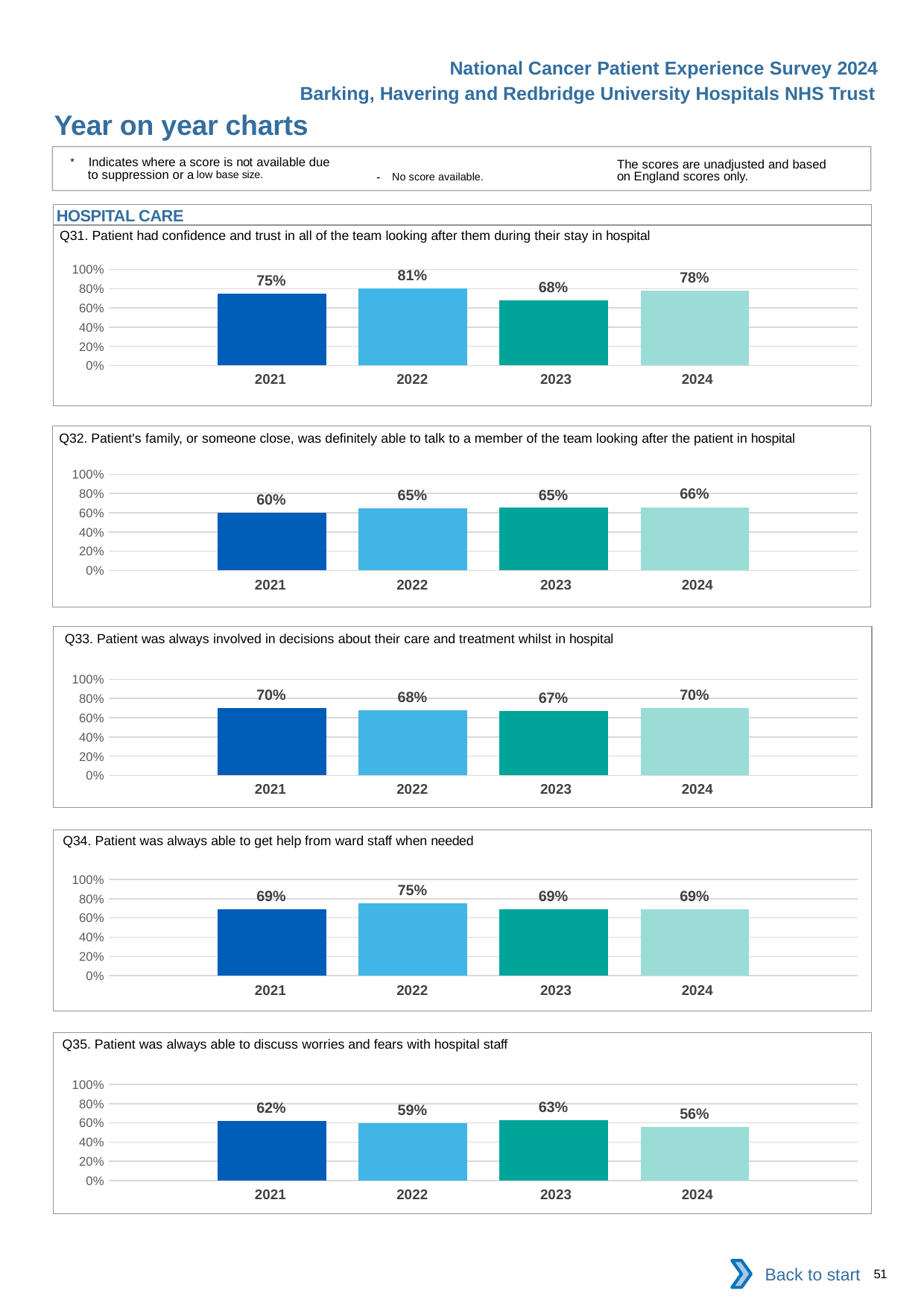
In the Q31 chart, which year has the lowest value? 2023 In the Q35 chart, which is larger, the value for 2021 or the value for 2024? 2021 In the Q33 chart, what is the value for 2022? 68% In the Q34 chart, which year has the highest value? 2022 In the Q31 chart, what is the value for 2022? 81% In the Q35 chart, what is the value for 2024? 56% In the Q32 chart, what is the value for 2021? 60% In the Q32 chart, what is the difference between the 2024 value and the 2021 value? 6% In the Q34 chart, what is the difference between the 2022 value and the 2023 value? 6% What kind of chart is the Q35 chart? Bar chart In the Q33 chart, which year has the lowest value? 2023 How many years are shown in the Q31 chart? 4